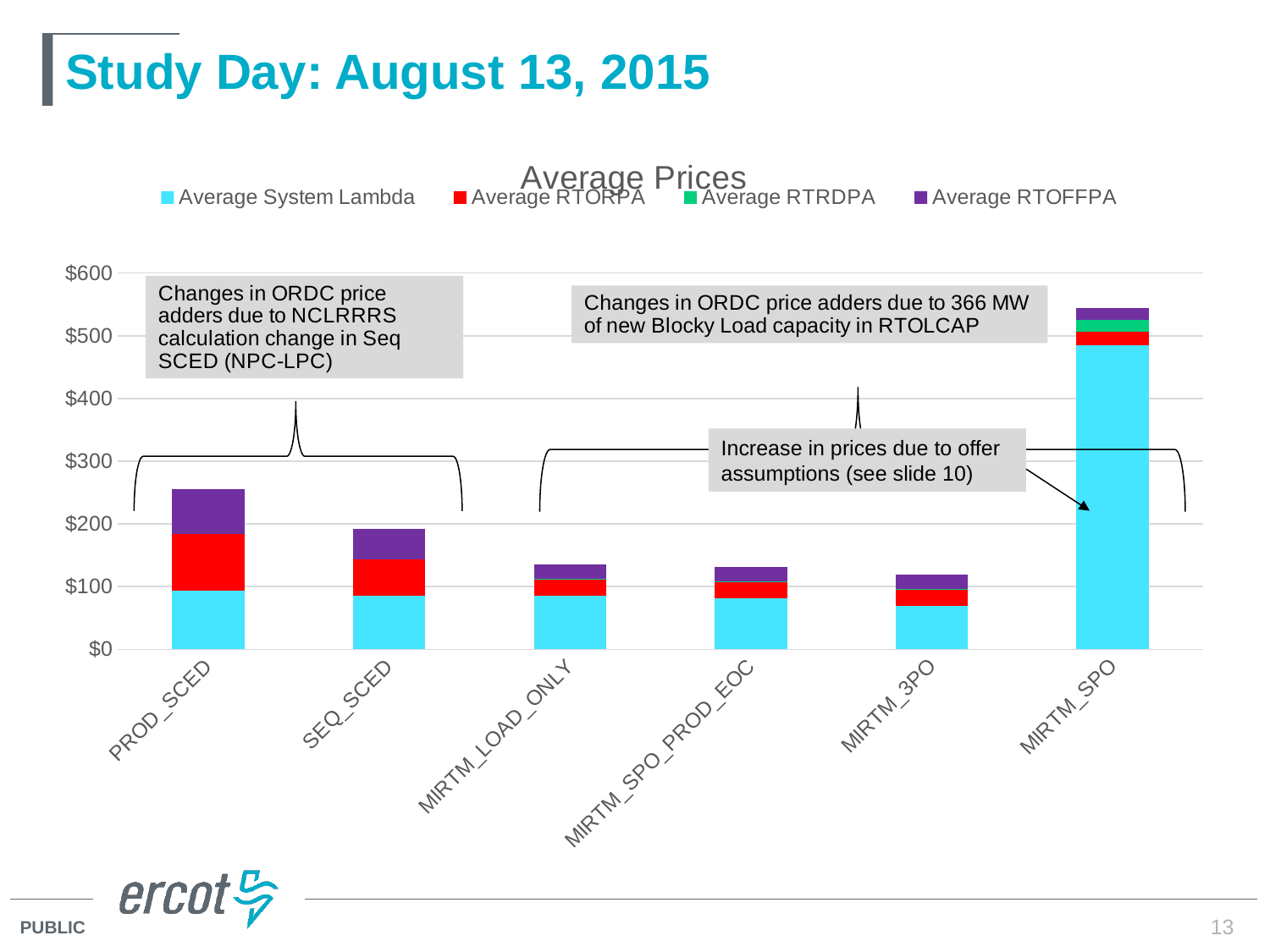
Is the total bar for MIRTM_3PO greater or less than $200? less Which series is shown in light blue in the chart legend? Average System Lambda Is the total bar for SEQ_SCED greater or less than $200? less How many series does the chart legend list? 4 Which category has the highest total bar in the chart? MIRTM_SPO Which has the larger total bar, MIRTM_SPO or PROD_SCED? MIRTM_SPO Which has the larger total bar, PROD_SCED or SEQ_SCED? PROD_SCED What is the title of the chart? Average Prices Is the total bar for MIRTM_SPO greater or less than $500? greater What kind of chart is shown on the slide? Stacked bar chart How many categories are shown on the x axis of the chart? 6